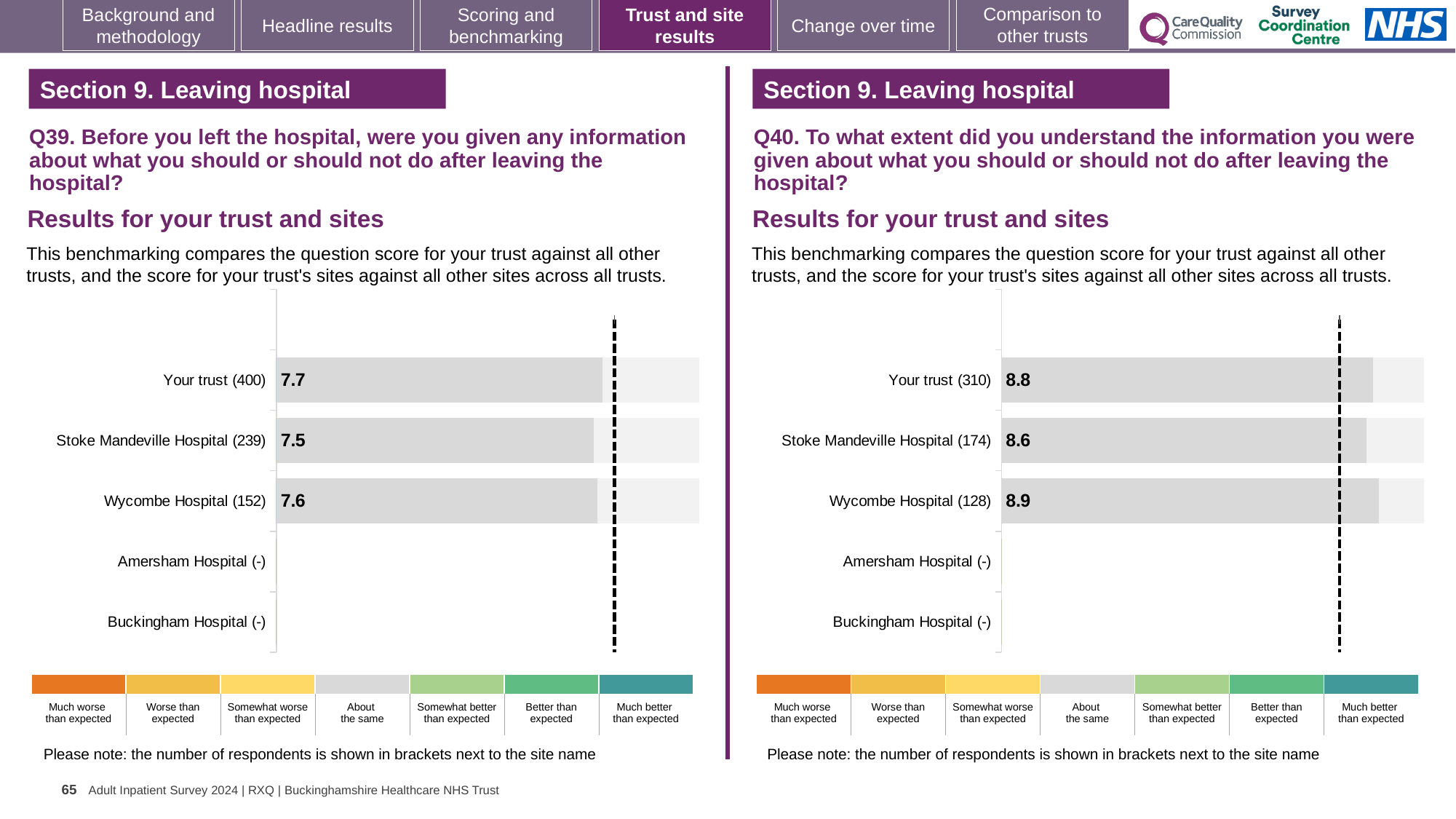
In the Q40 chart on the right, what is the score for Your trust? 8.8 In the Q40 chart on the right, what is the difference between the scores for Wycombe Hospital and Stoke Mandeville Hospital? 0.3 In the Q39 chart on the left, what is the difference between the scores for Your trust and Stoke Mandeville Hospital? 0.2 What kind of chart is used for the Q40 results on the right? Bar chart In the Q40 chart on the right, what is the score for Wycombe Hospital? 8.9 In the Q39 chart on the left, how many respondents are shown in brackets for Wycombe Hospital? 152 In the Q39 chart on the left, which of the three scored rows has the lowest score? Stoke Mandeville Hospital In the Q39 chart on the left, what is the score for Your trust? 7.7 In the Q40 chart on the right, which has the higher score: Your trust or Stoke Mandeville Hospital? Your trust How many rows (sites including Your trust) are listed on the y axis of the Q39 chart on the left? 5 In the Q39 chart on the left, what is the score for Stoke Mandeville Hospital? 7.5 In the Q40 chart on the right, which of the three scored rows has the highest score? Wycombe Hospital